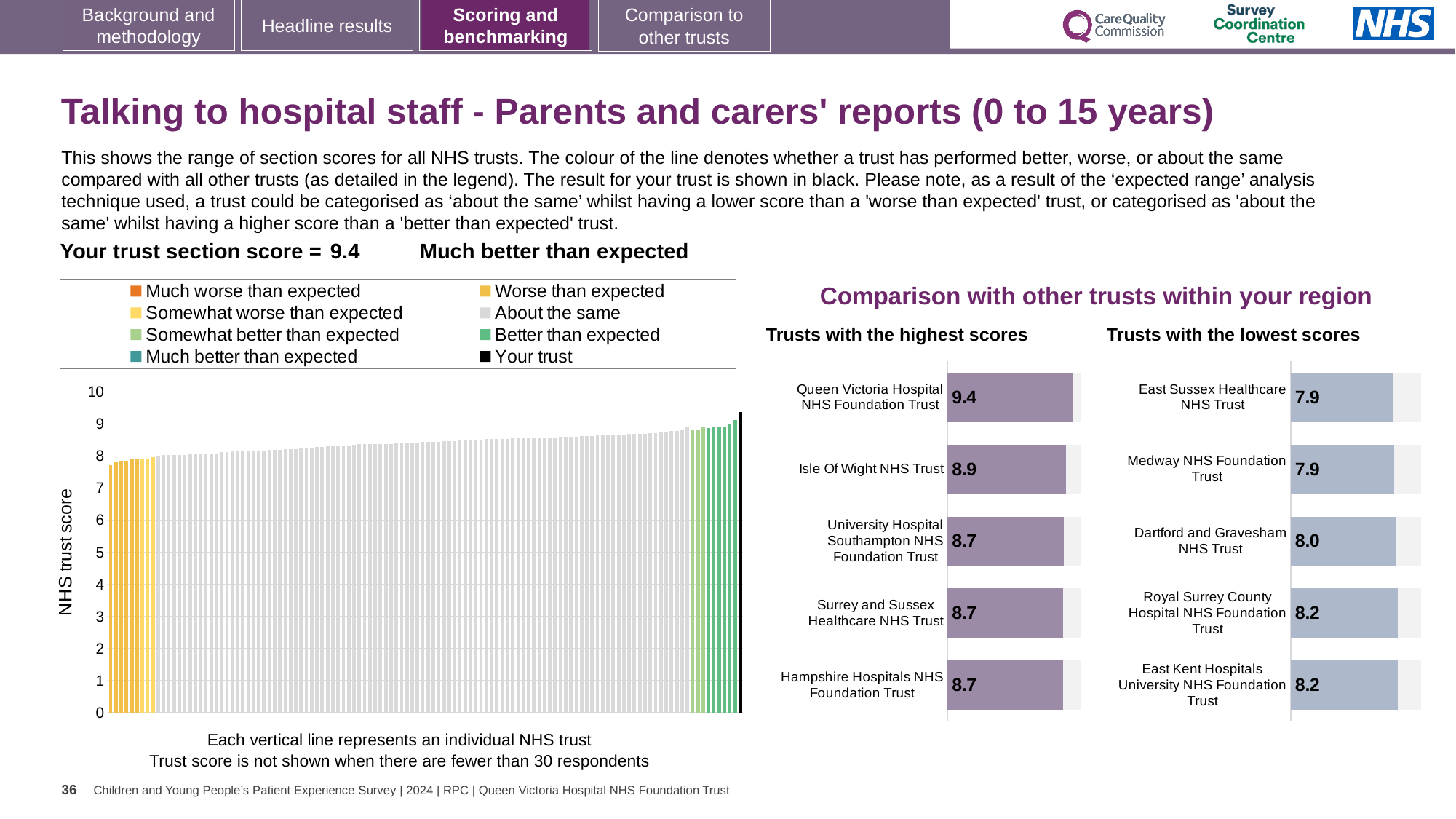
What kind of chart is the main chart on the left showing all NHS trusts? Bar chart In the 'Trusts with the lowest scores' chart, which has the larger score: East Kent Hospitals University NHS Foundation Trust or Medway NHS Foundation Trust? East Kent Hospitals University NHS Foundation Trust What is the label on the vertical axis of the main chart on the left? NHS trust score How many trusts are shown in the 'Trusts with the lowest scores' chart? 5 How many trusts are shown in the 'Trusts with the highest scores' chart? 5 In the 'Trusts with the lowest scores' chart, what is the score for Dartford and Gravesham NHS Trust? 8.0 In the 'Trusts with the highest scores' chart, what is the score for Isle Of Wight NHS Trust? 8.9 How many entries does the legend of the main chart on the left list? 8 In the 'Trusts with the lowest scores' chart, what is the difference between the scores of Royal Surrey County Hospital NHS Foundation Trust and East Sussex Healthcare NHS Trust? 0.3 In the 'Trusts with the highest scores' chart, what is the difference between the scores of Queen Victoria Hospital NHS Foundation Trust and Isle Of Wight NHS Trust? 0.5 In the 'Trusts with the highest scores' chart, which trust has the highest score? Queen Victoria Hospital NHS Foundation Trust In the 'Trusts with the highest scores' chart, which has the larger score: Queen Victoria Hospital NHS Foundation Trust or Hampshire Hospitals NHS Foundation Trust? Queen Victoria Hospital NHS Foundation Trust